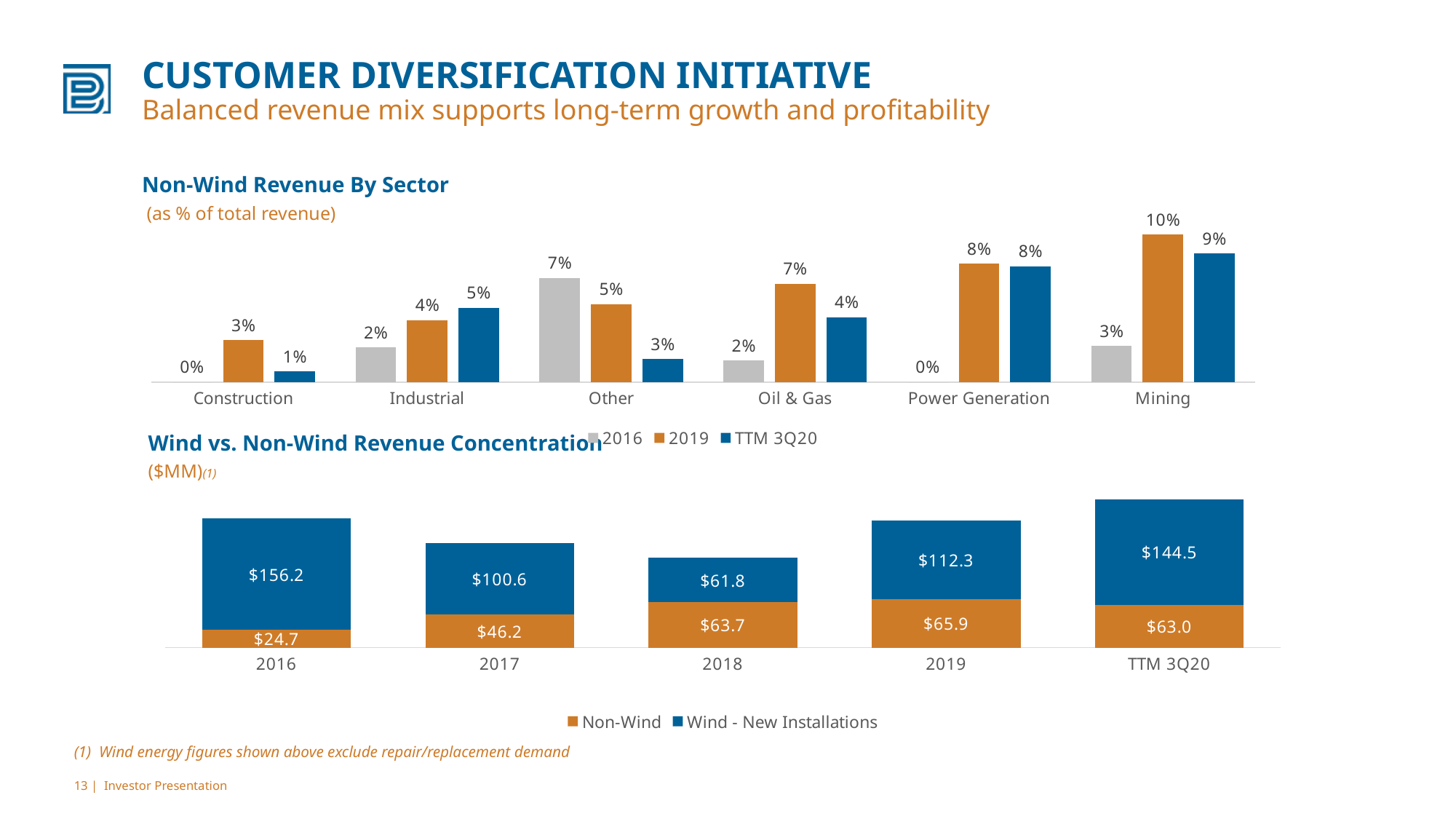
In the 'Wind vs. Non-Wind Revenue Concentration' chart, what is the Non-Wind value for 2019? $65.9 In the 'Wind vs. Non-Wind Revenue Concentration' chart, what is the total of the 2018 stacked bar? $125.5 What kind of chart is the 'Wind vs. Non-Wind Revenue Concentration' chart? Stacked bar chart In the 'Non-Wind Revenue By Sector' chart, what is the difference between the 2019 and 2016 values for Oil & Gas? 5% In the 'Non-Wind Revenue By Sector' chart, what is the TTM 3Q20 value for Oil & Gas? 4% In the 'Wind vs. Non-Wind Revenue Concentration' chart, which is larger in 2017: Non-Wind or Wind - New Installations? Wind - New Installations In the 'Non-Wind Revenue By Sector' chart, how many sectors are shown on the x axis? 6 In the 'Non-Wind Revenue By Sector' chart, how many series does the legend list? 3 In the 'Non-Wind Revenue By Sector' chart, what is the 2016 value for Other? 7% In the 'Non-Wind Revenue By Sector' chart, what is the 2019 value for Mining? 10% In the 'Non-Wind Revenue By Sector' chart, which sector has the highest TTM 3Q20 value? Mining In the 'Wind vs. Non-Wind Revenue Concentration' chart, what is the Wind - New Installations value for 2016? $156.2